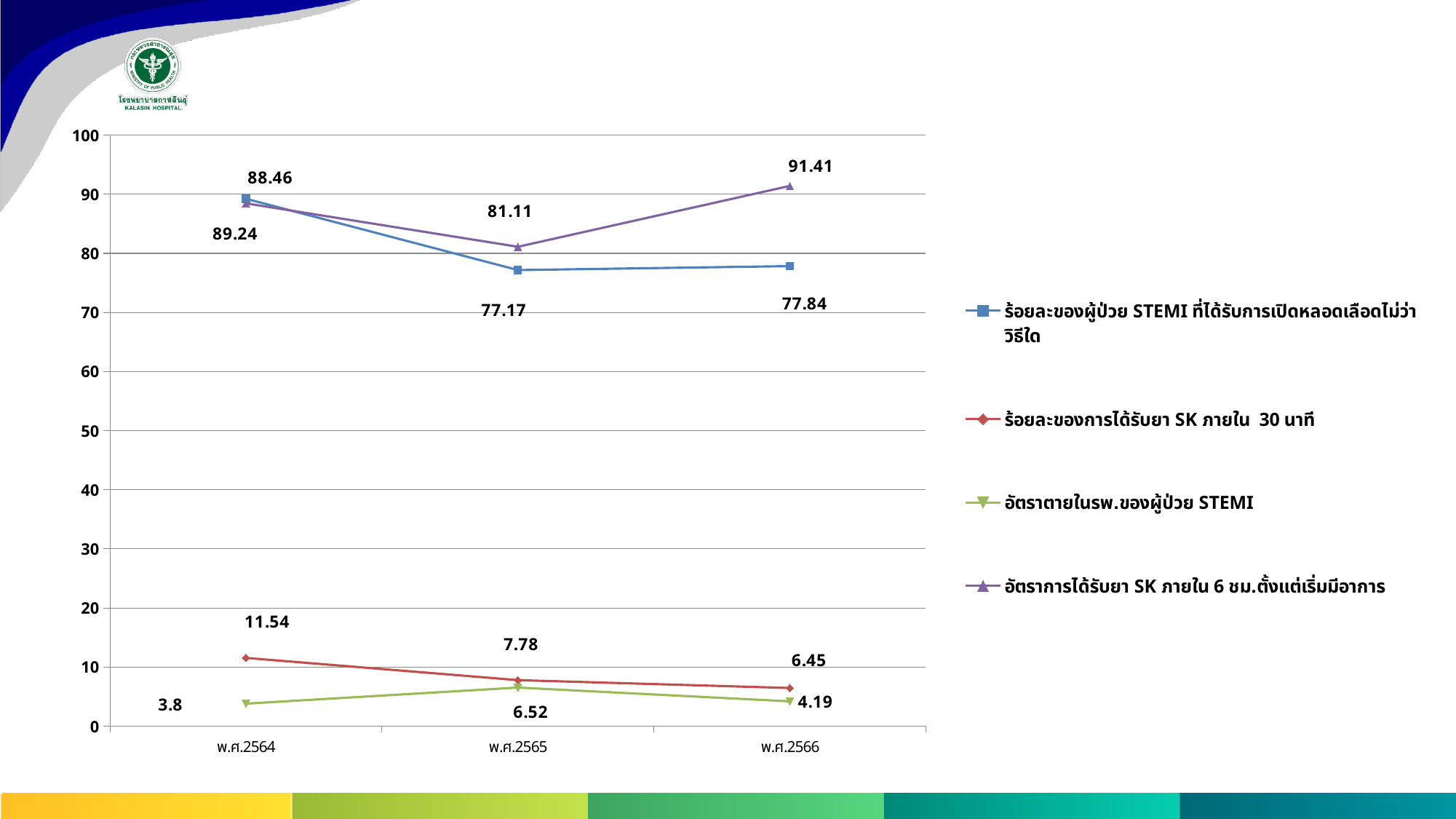
What is the value of อัตราการได้รับยา SK ภายใน 6 ชม.ตั้งแต่เริ่มมีอาการ in พ.ศ.2565? 81.11 How many series does the legend list? 4 Does ร้อยละของการได้รับยา SK ภายใน 30 นาที rise or fall from พ.ศ.2564 to พ.ศ.2566? fall In which year is ร้อยละของการได้รับยา SK ภายใน 30 นาที lowest? พ.ศ.2566 What is the value of ร้อยละของผู้ป่วย STEMI ที่ได้รับการเปิดหลอดเลือดไม่ว่าวิธีใด in พ.ศ.2565? 77.17 Is the value of ร้อยละของผู้ป่วย STEMI ที่ได้รับการเปิดหลอดเลือดไม่ว่าวิธีใด in พ.ศ.2566 greater or less than 80? less What type of chart is shown on the slide? line chart What is the value of อัตราการได้รับยา SK ภายใน 6 ชม.ตั้งแต่เริ่มมีอาการ in พ.ศ.2566? 91.41 How many points along the x axis does the chart have? 3 What is the difference between ร้อยละของการได้รับยา SK ภายใน 30 นาที in พ.ศ.2564 and พ.ศ.2566? 5.09 What is the value of อัตราตายในรพ.ของผู้ป่วย STEMI in พ.ศ.2565? 6.52 What is the value of ร้อยละของการได้รับยา SK ภายใน 30 นาที in พ.ศ.2564? 11.54